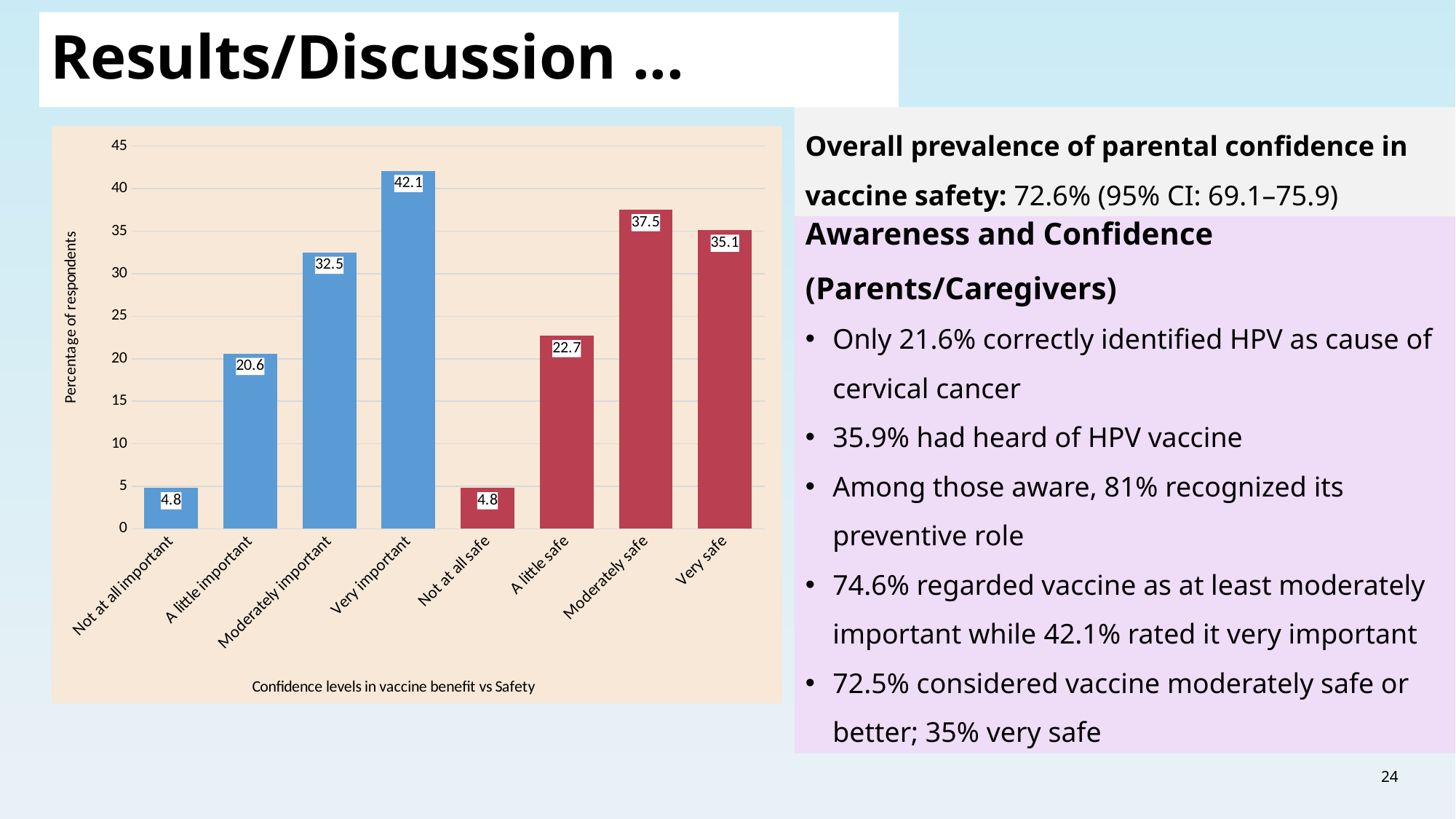
What is the y-axis title of the chart? Percentage of respondents What is the difference between 'Moderately safe' and 'Very safe'? 2.4 Which category has the highest value? Very important What is the value for 'Very important'? 42.1 What is the difference between 'Very important' and 'Moderately important'? 9.6 What is the value for 'A little safe'? 22.7 Which is larger, 'A little important' or 'A little safe'? A little safe What is the value for 'Moderately safe'? 37.5 What is the x-axis title of the chart? Confidence levels in vaccine benefit vs Safety What kind of chart is this? Bar chart Which is larger, 'Very important' or 'Very safe'? Very important How many categories are shown on the x axis? 8